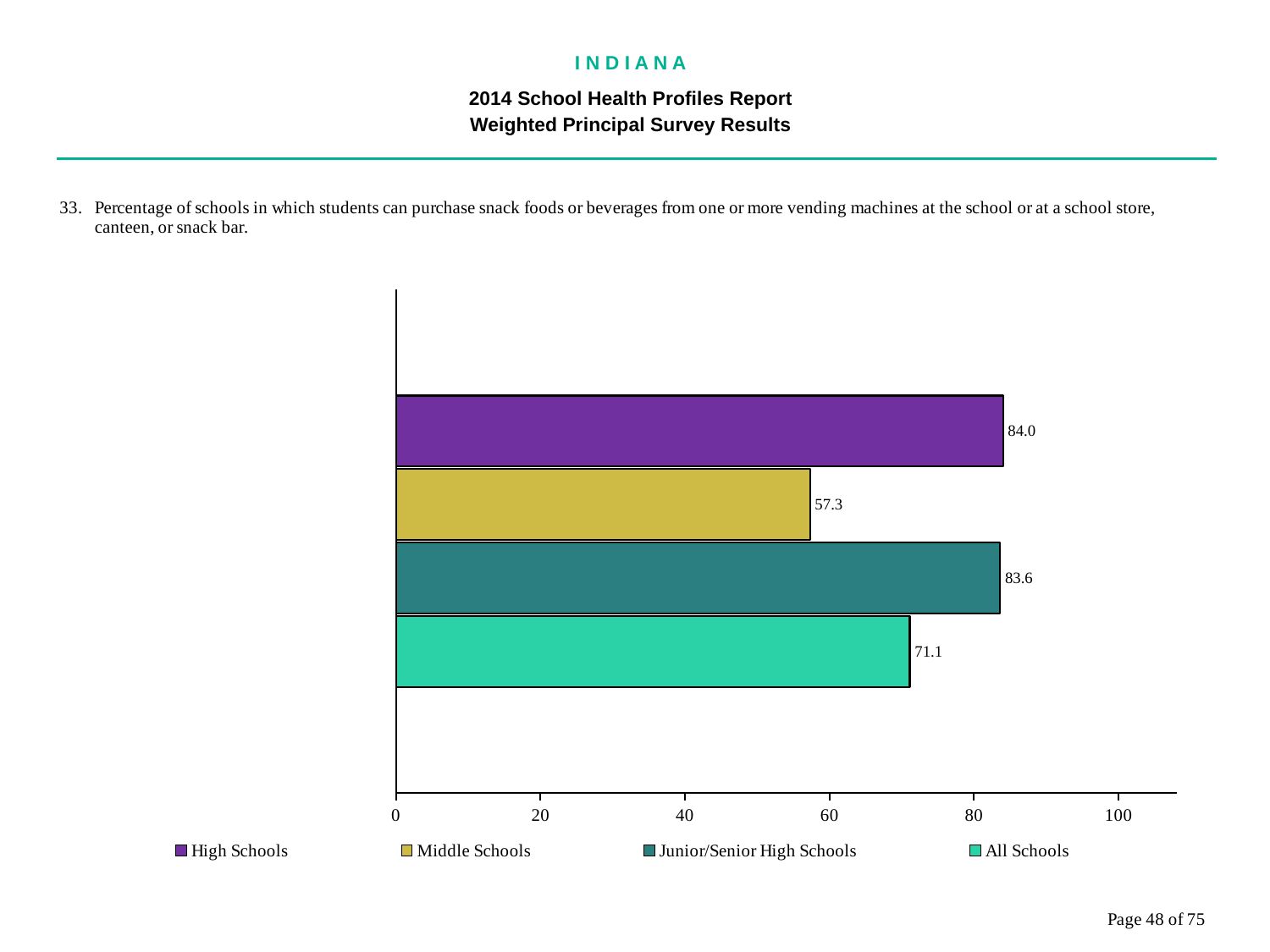
What is the value for Middle Schools? 57.3 Which is larger, the value for Middle Schools or the value for All Schools? All Schools What is the value for All Schools? 71.1 How many bars are shown in the chart? 4 What is the value for High Schools? 84.0 What kind of chart is shown on the slide? bar chart What is the value for Junior/Senior High Schools? 83.6 What is the difference between the values for High Schools and Middle Schools? 26.7 Which school type has the lowest value? Middle Schools Is the value for Middle Schools greater or less than 60? less How many series does the legend list? 4 What is the difference between the values for Junior/Senior High Schools and All Schools? 12.5